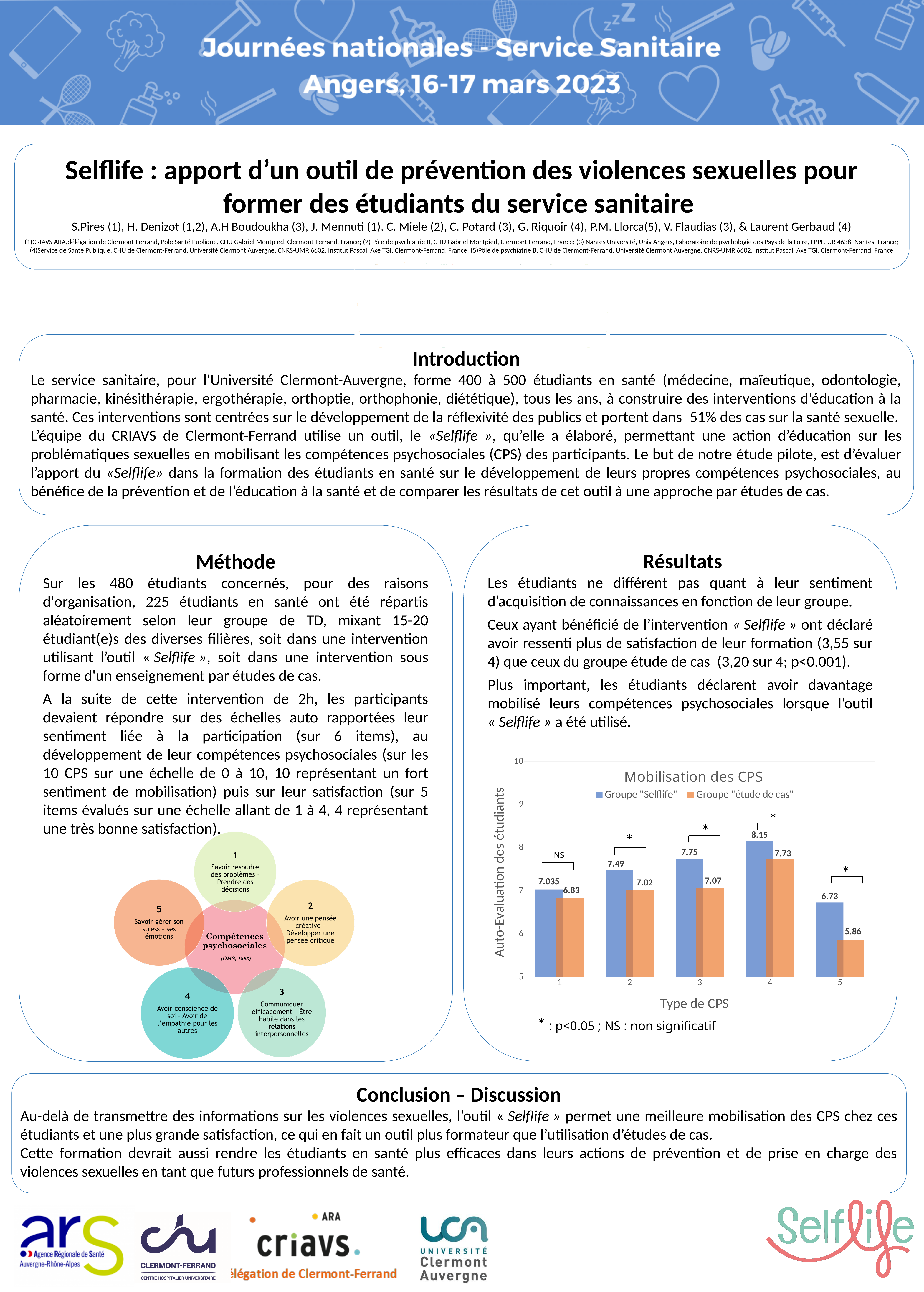
For which CPS type is the Groupe "étude de cas" value lowest? 5 How many types of CPS are shown on the x axis of the chart? 5 What is the value for Groupe "Selflife" for CPS type 1? 7.035 What type of chart is shown in the Résultats section? bar chart What is the value for Groupe "étude de cas" for CPS type 5? 5.86 What is the value for Groupe "Selflife" for CPS type 4? 8.15 What is the difference between the Groupe "Selflife" and Groupe "étude de cas" values for CPS type 5? 0.87 How many series does the chart legend list? 2 For which CPS type is the Groupe "Selflife" value highest? 4 What is the title of the chart? Mobilisation des CPS What is the label of the y axis of the chart? Auto-Evaluation des étudiants For CPS type 3, which group has the larger value, Groupe "Selflife" or Groupe "étude de cas"? Groupe "Selflife"